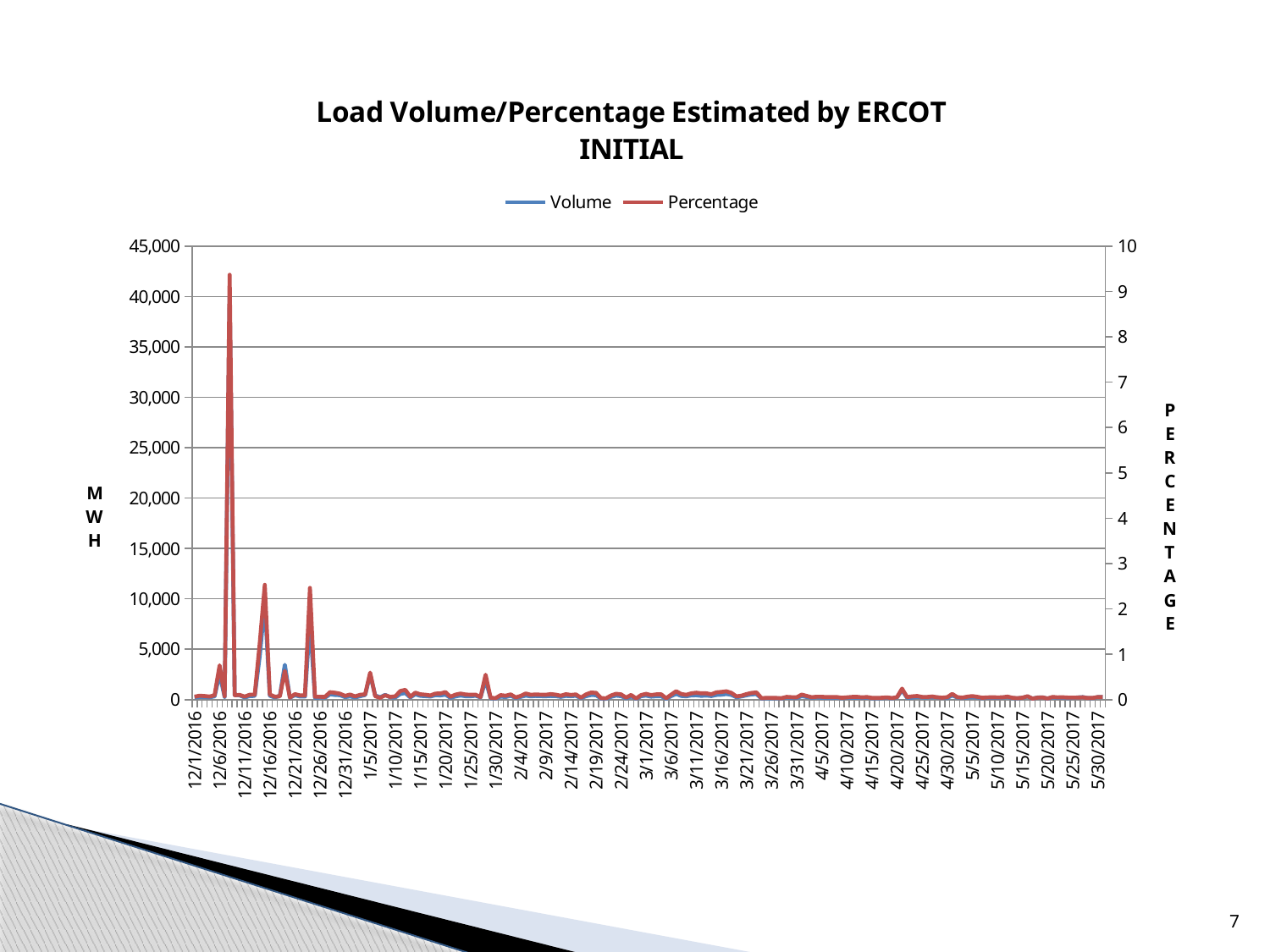
What is the title of the chart? Load Volume/Percentage Estimated by ERCOT INITIAL What are the two series named in the legend? Volume and Percentage What is the highest tick value shown on the left (MWH) axis? 45,000 What is the highest tick value shown on the right (Percentage) axis? 10 Is the Volume value on 5/30/2017 greater or less than 5,000? less Overall, do the plotted values rise or fall from December 2016 to May 2017? fall How many series does the legend list? 2 What kind of chart is shown on the slide? line chart Is the Volume value in early December 2016 (the largest spike) larger or smaller than the Volume value on 4/20/2017? larger Is the Percentage value on 3/1/2017 greater or less than 1? less Is the peak value of the Percentage series greater or less than 8 on the right axis? greater